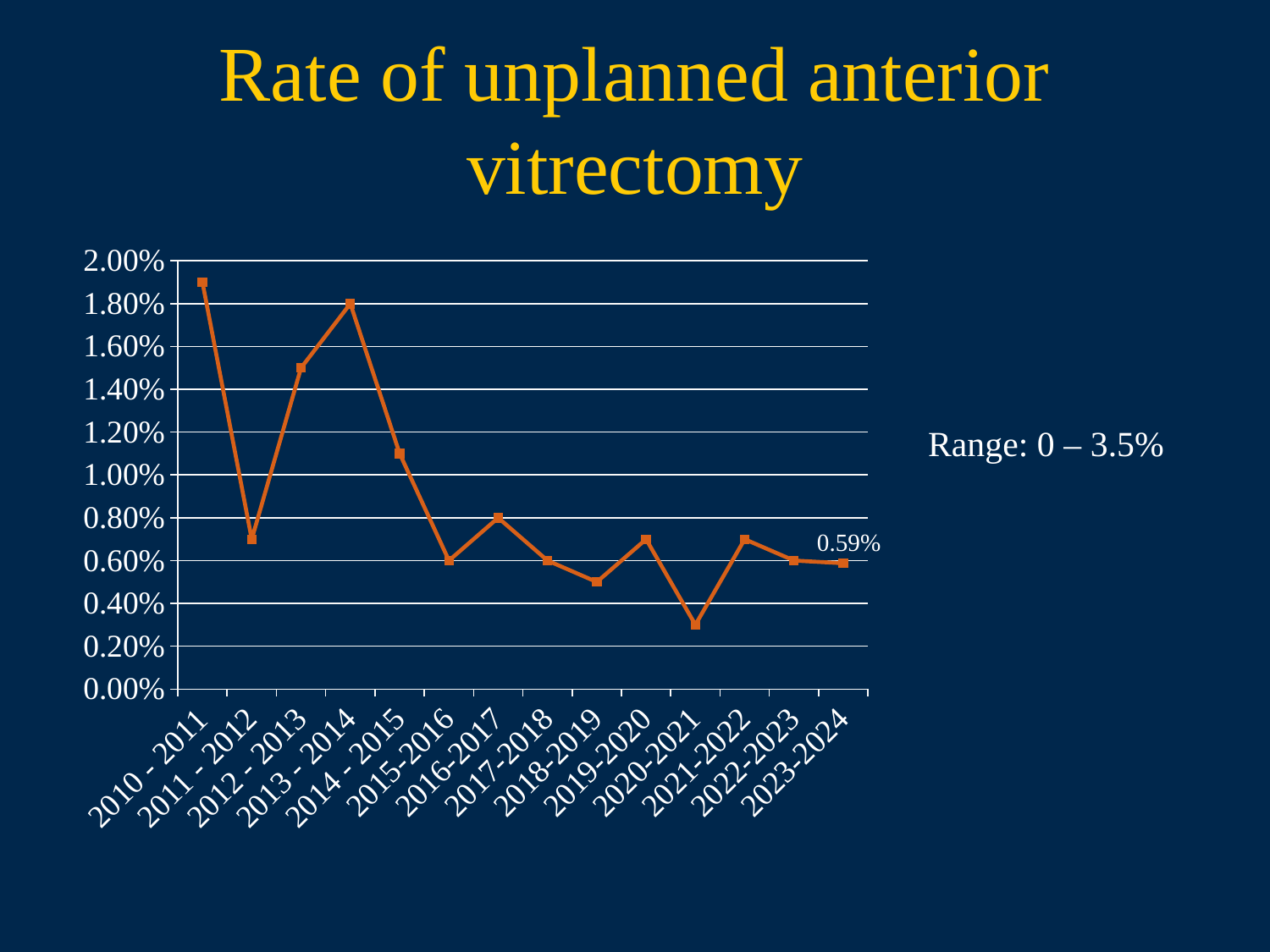
What is the rate of unplanned anterior vitrectomy for 2023-2024? 0.59% What range is stated in the text next to the chart? 0 – 3.5% Which period has the highest rate of unplanned anterior vitrectomy? 2010 - 2011 Which period has the lowest rate of unplanned anterior vitrectomy? 2020-2021 What kind of chart is shown on the slide? line chart Which is larger, the rate for 2011 - 2012 or the rate for 2012 - 2013? 2012 - 2013 What is the rate for 2016-2017? 0.80% What is the rate for 2013 - 2014? 1.80% Is the value for 2020-2021 greater or less than 0.40%? less Is the value for 2014 - 2015 greater or less than 1.00%? greater How many periods are plotted on the x axis? 14 Overall, does the rate rise or fall from 2010 - 2011 to 2023-2024? fall